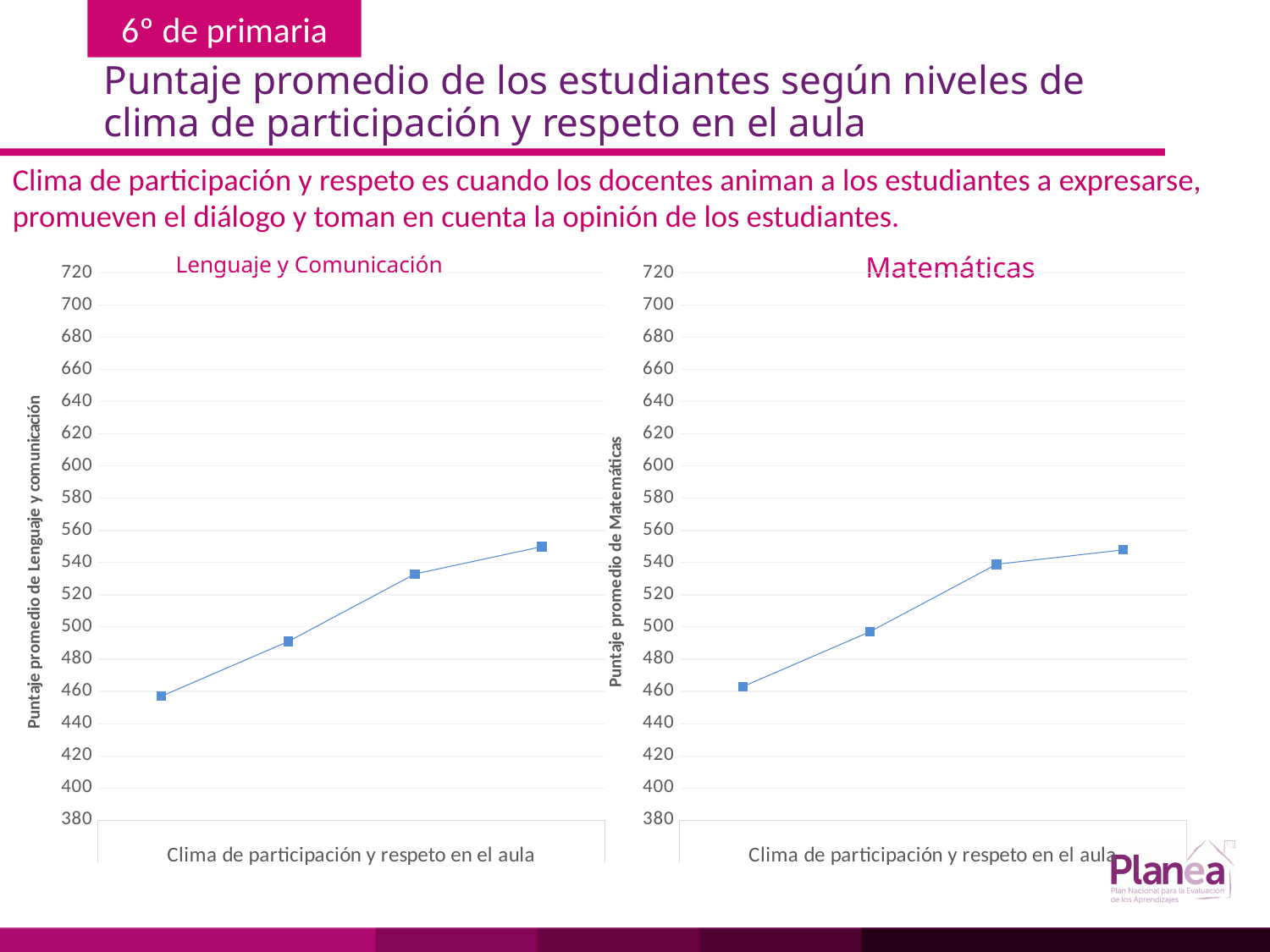
What kind of chart is the Lenguaje y Comunicación chart on the left? line chart In the Matemáticas chart, how many data points are plotted on the line? 4 In the Matemáticas chart, is the value of the last (rightmost) point greater or less than 520? greater In the Lenguaje y Comunicación chart, do the values rise or fall from left to right along the x axis? rise What is the x-axis title of the Lenguaje y Comunicación chart? Clima de participación y respeto en el aula In the Lenguaje y Comunicación chart, is the value of the first (leftmost) point greater or less than 480? less What is the title of the chart on the right? Matemáticas In the Matemáticas chart, is the value of the first (leftmost) point greater or less than 480? less What kind of chart is the Matemáticas chart on the right? line chart In the Matemáticas chart, do the values rise or fall from left to right along the x axis? rise In the Lenguaje y Comunicación chart, how many data points are plotted on the line? 4